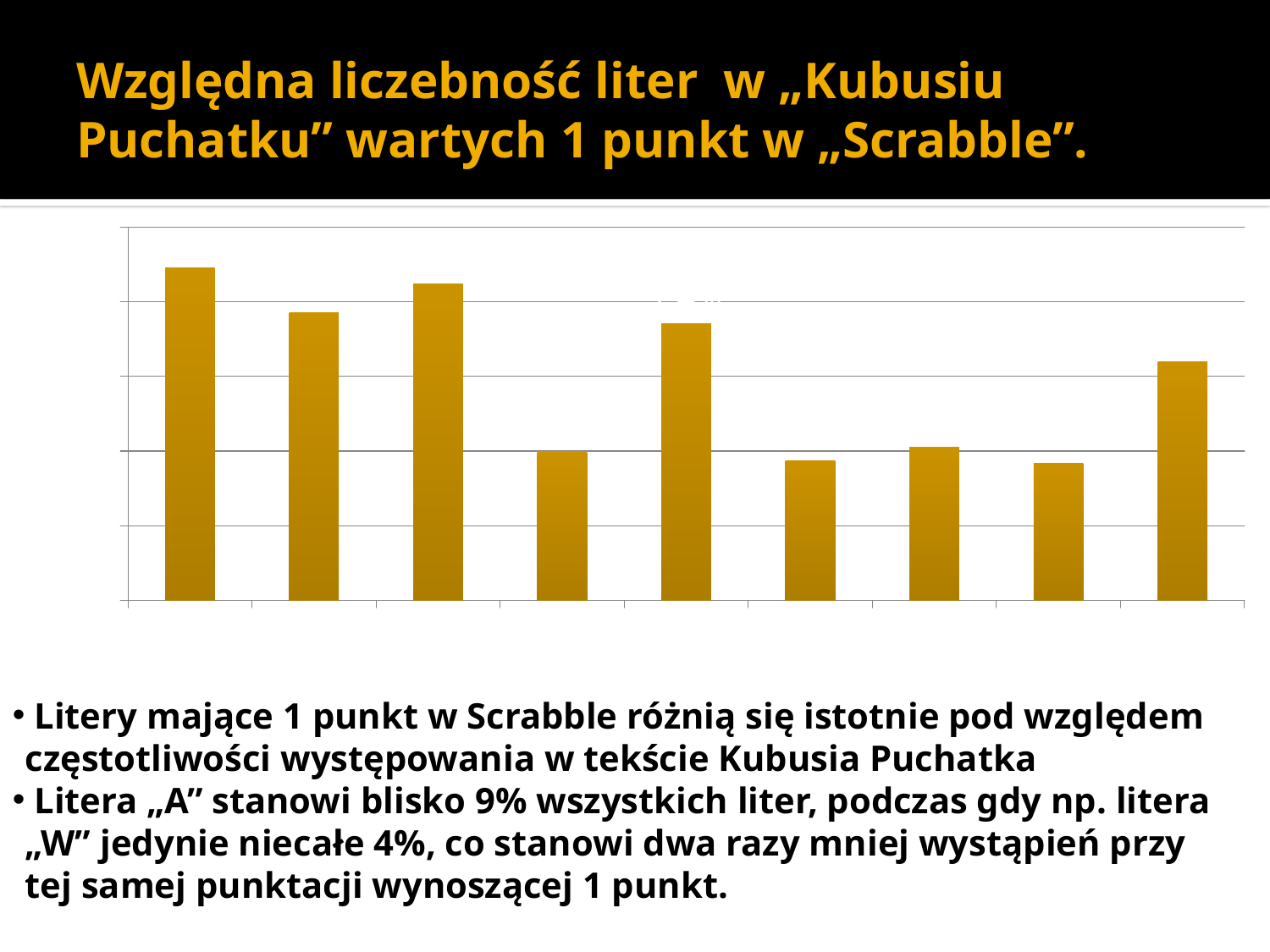
Which is taller, the first bar from the left or the last bar on the right? the first bar from the left What colour are the bars in the chart? gold (orange-yellow) Which is taller, the second bar from the left or the fifth bar from the left? the second bar Which is taller, the last bar on the right or the seventh bar from the left? the last bar on the right How many bars does the chart contain? 9 Which bar is the tallest in the chart, counting from the left? the first bar What kind of chart is shown on the slide? bar chart Do the bar heights rise steadily, fall steadily, or fluctuate from left to right? fluctuate Are the bars in the chart vertical or horizontal? vertical